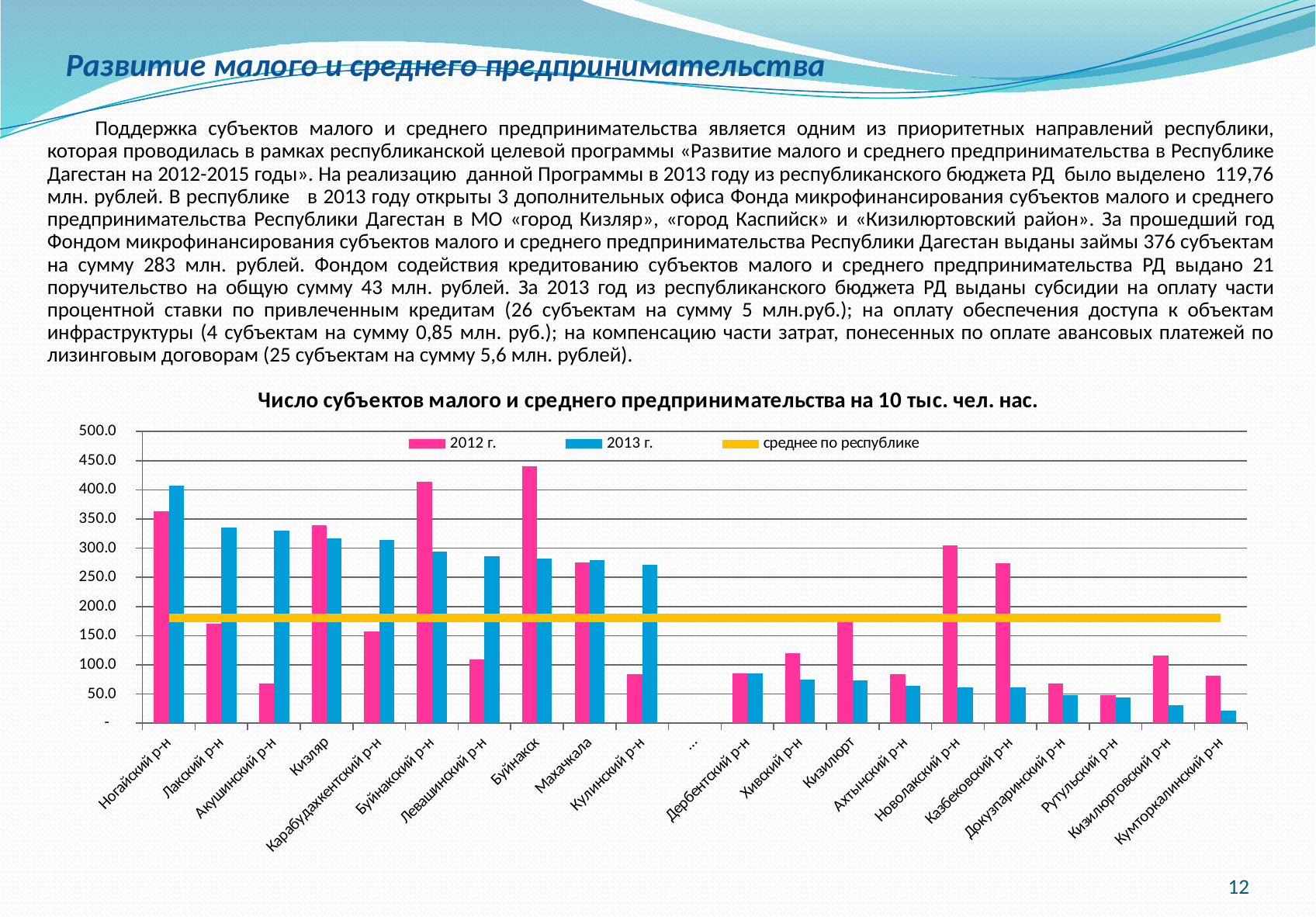
Is the 2012 г. value for Кизляр greater or less than 300? greater For Ногайский р-н, which is larger: the 2012 г. value or the 2013 г. value? 2013 г. How many series does the chart legend list? 3 What is the title of the chart? Число субъектов малого и среднего предпринимательства на 10 тыс. чел. нас. Is the 2012 г. value for Буйнакск greater or less than 400? greater Which category has the highest 2012 г. value? Буйнакск What kind of chart is shown on the slide? bar chart Is the 2013 г. value for Кулинский р-н greater or less than 250? greater Which category has the highest 2013 г. value? Ногайский р-н For Лакский р-н, which is larger: the 2012 г. value or the 2013 г. value? 2013 г. For Буйнакск, which is larger: the 2012 г. value or the 2013 г. value? 2012 г.